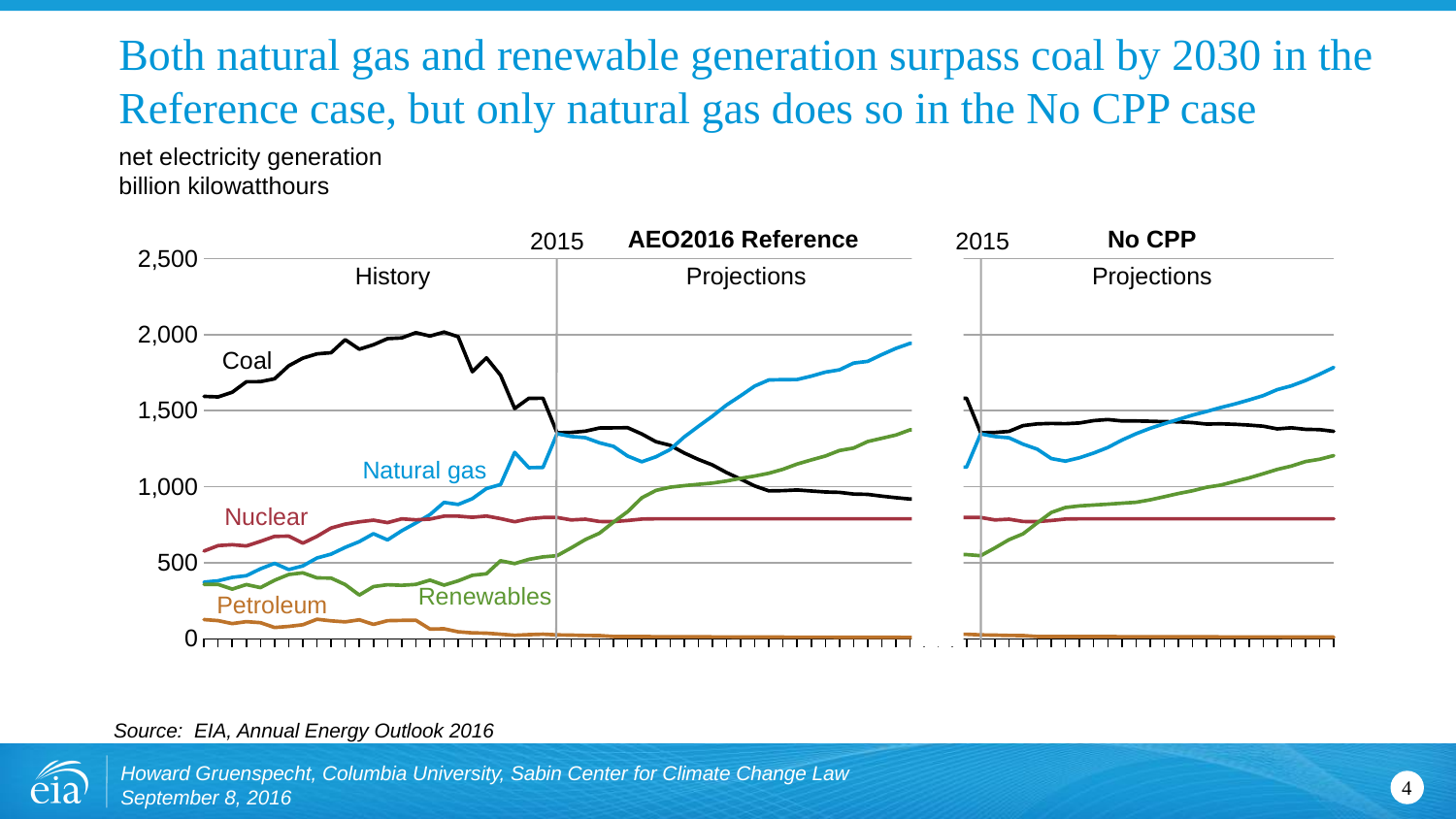
What kind of chart is used on this slide? line chart In the AEO2016 Reference chart, which series has the highest value at the end of the projection period? Natural gas In the AEO2016 Reference chart, does coal generation rise or fall over the projection period? fall In the AEO2016 Reference chart, is the natural gas value at the end of the projection period greater or less than 1,500? greater In the AEO2016 Reference chart, at the end of the projection period, which is larger: renewables or nuclear? Renewables In the No CPP chart, is the renewables value at the end of the projection period greater or less than 1,000? greater In the No CPP chart, which series has the highest value at the end of the projection period? Natural gas How many fuel series are plotted in the AEO2016 Reference chart? 5 In the AEO2016 Reference chart, which series has the lowest values throughout? Petroleum In the AEO2016 Reference chart, does renewables generation rise or fall over the projection period? rise What unit is net electricity generation measured in on the y axis? billion kilowatthours In the No CPP chart, is the coal value at the end of the projection period greater or less than 1,000? greater